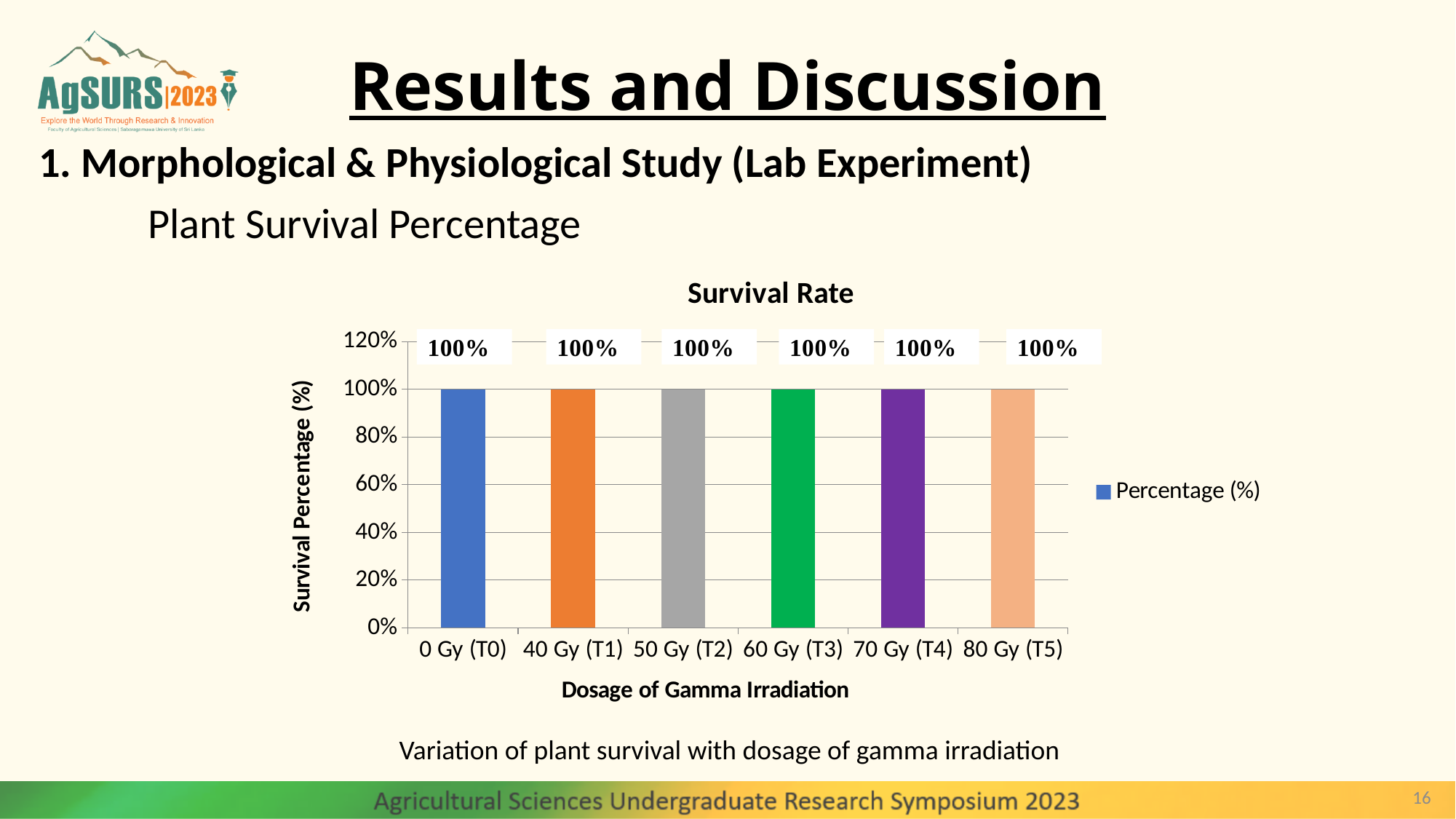
Do the survival percentages rise, fall, or stay flat as the gamma irradiation dosage increases? stay flat What is the survival percentage for 60 Gy (T3)? 100% How many series does the legend list? 1 What is the title of the chart? Survival Rate How many dosage categories are shown on the x axis? 6 What kind of chart is shown? bar chart What is the survival percentage for 40 Gy (T1)? 100% What is the difference between the survival percentage for 0 Gy (T0) and 80 Gy (T5)? 0% What is the survival percentage for 0 Gy (T0)? 100% What is the label of the x axis? Dosage of Gamma Irradiation What is the survival percentage for 80 Gy (T5)? 100% Is the value for 70 Gy (T4) greater or less than 80%? greater